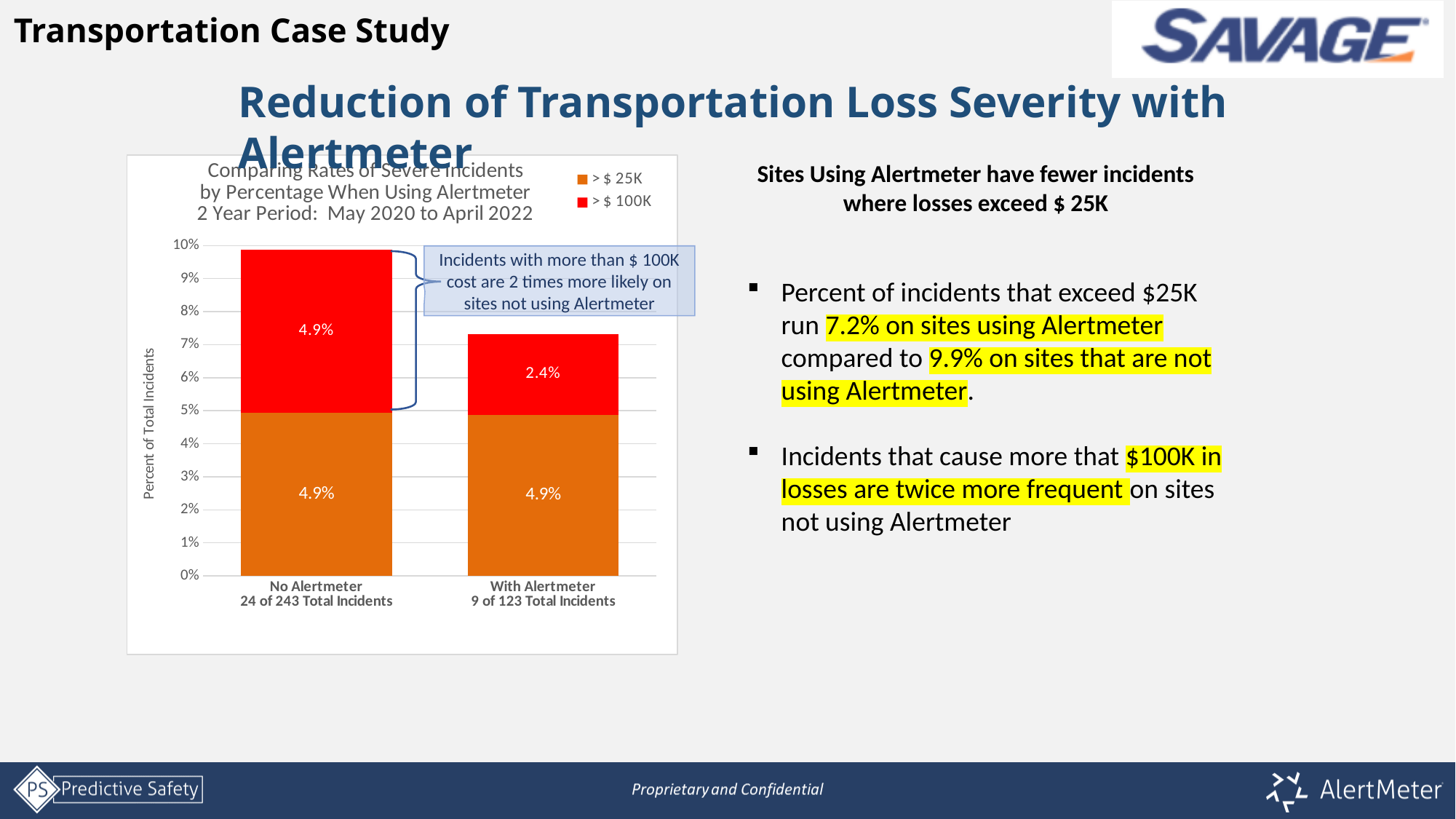
What is the value of the > $ 25K segment for With Alertmeter? 4.9% Is the total stacked bar for With Alertmeter greater or less than 8%? less What is the difference between the > $ 100K values for No Alertmeter and With Alertmeter? 2.5% Is the total stacked bar for No Alertmeter greater or less than 9%? greater Which is larger: the > $ 100K value for No Alertmeter or for With Alertmeter? No Alertmeter Which category has the lower > $ 100K value? With Alertmeter How many series does the chart legend list? 2 What kind of chart is shown on the slide? stacked bar chart What is the value of the > $ 100K segment for No Alertmeter? 4.9% What is the value of the > $ 100K segment for With Alertmeter? 2.4% How many categories are shown on the x axis of the chart? 2 Which colour represents the > $ 100K series in the chart? red